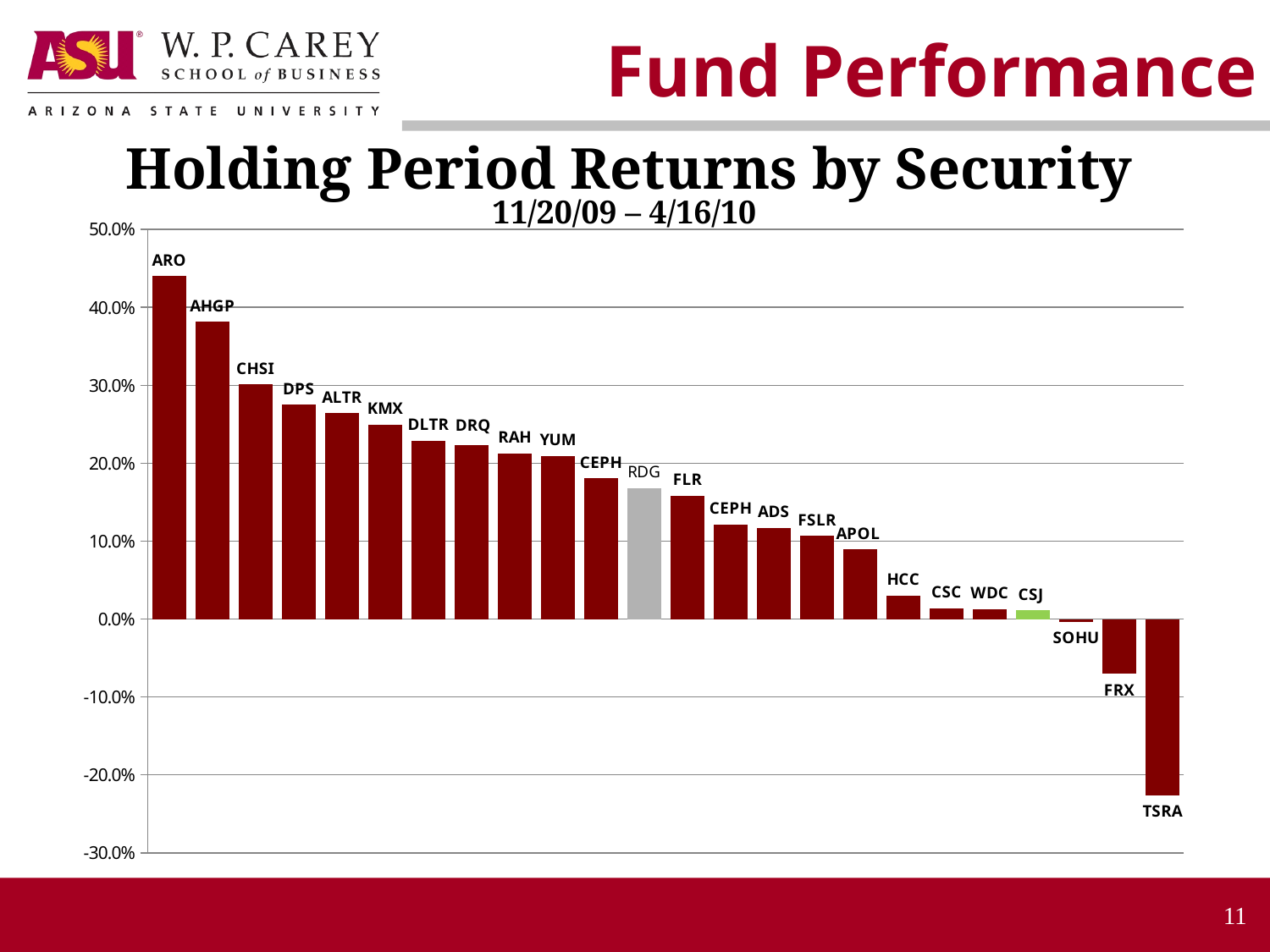
Which security has the lowest holding period return? TSRA How many securities (bars) are plotted in the chart? 24 Is the holding period return for APOL greater or less than 10.0%? less Is the holding period return for TSRA greater or less than -20.0%? less What date range is shown in the chart's subtitle? 11/20/09 – 4/16/10 Do the holding period returns rise or fall moving from left to right across the chart? fall Is the holding period return for ARO greater or less than 40.0%? greater Which security has the highest holding period return? ARO Which has the larger holding period return, DPS or FSLR? DPS What kind of chart is shown on the slide? bar chart